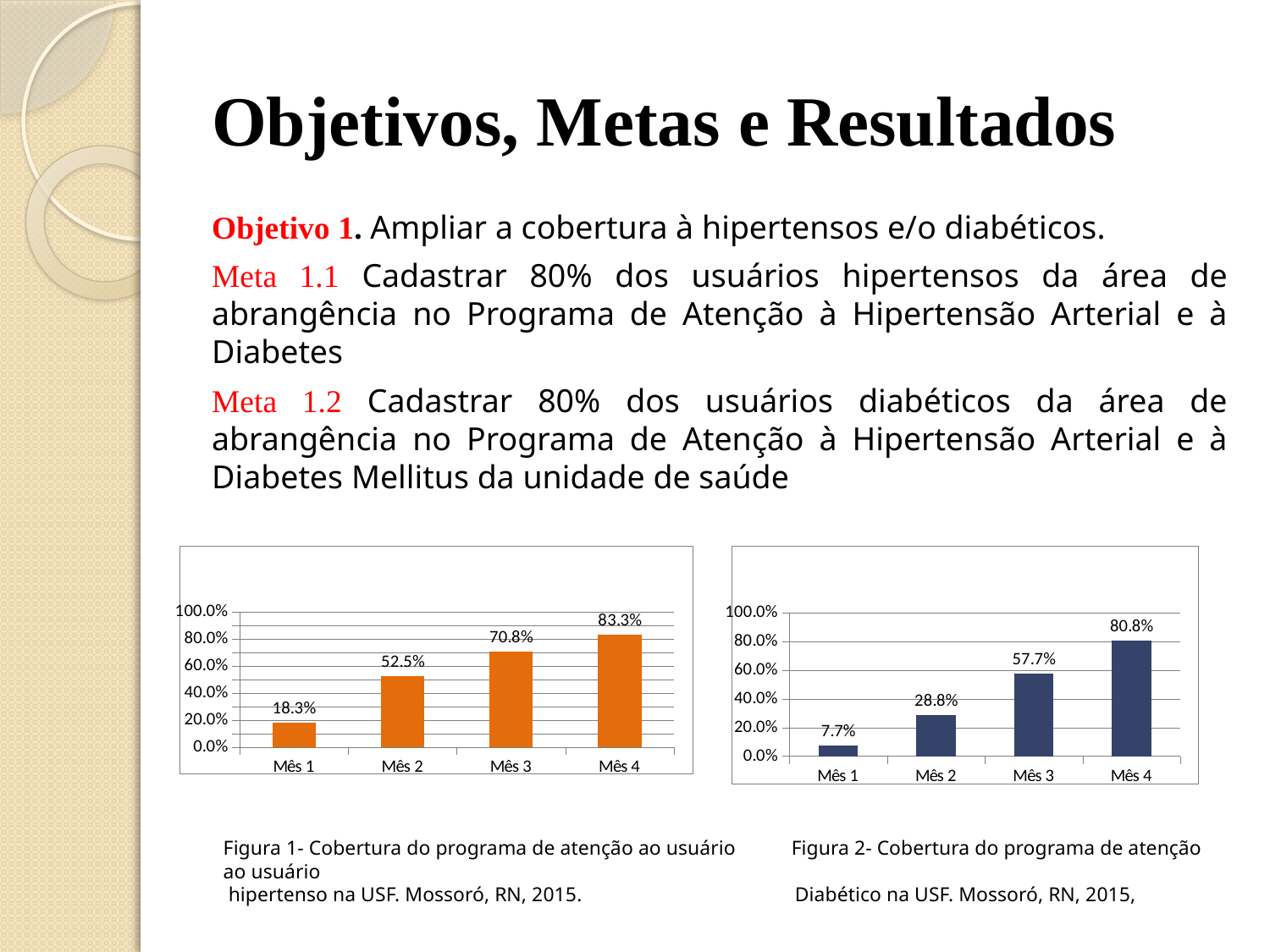
What colour are the bars in the right chart (Figura 2, Diabético)? Dark blue In the left chart (Figura 1, hipertenso), do the values rise or fall from Mês 1 to Mês 4? Rise In the right chart (Figura 2, Diabético), what is the value for Mês 3? 57.7% What kind of chart is the right chart (Figura 2, Diabético)? Bar chart In the right chart (Figura 2, Diabético), which month has the lowest value? Mês 1 Which is larger: the Mês 4 value in the left chart (Figura 1) or the Mês 4 value in the right chart (Figura 2)? Left chart (Figura 1), 83.3% In the right chart (Figura 2, Diabético), is the value for Mês 2 greater or less than 40.0%? less How many months (categories) are shown in the left chart (Figura 1, hipertenso)? 4 In the right chart (Figura 2, Diabético), what is the difference between the values for Mês 4 and Mês 3? 23.1% In the left chart (Figura 1, hipertenso), what is the value for Mês 2? 52.5% In the left chart (Figura 1, hipertenso), what is the difference between the values for Mês 4 and Mês 1? 65.0% In the left chart (Figura 1, hipertenso), which month has the highest value? Mês 4